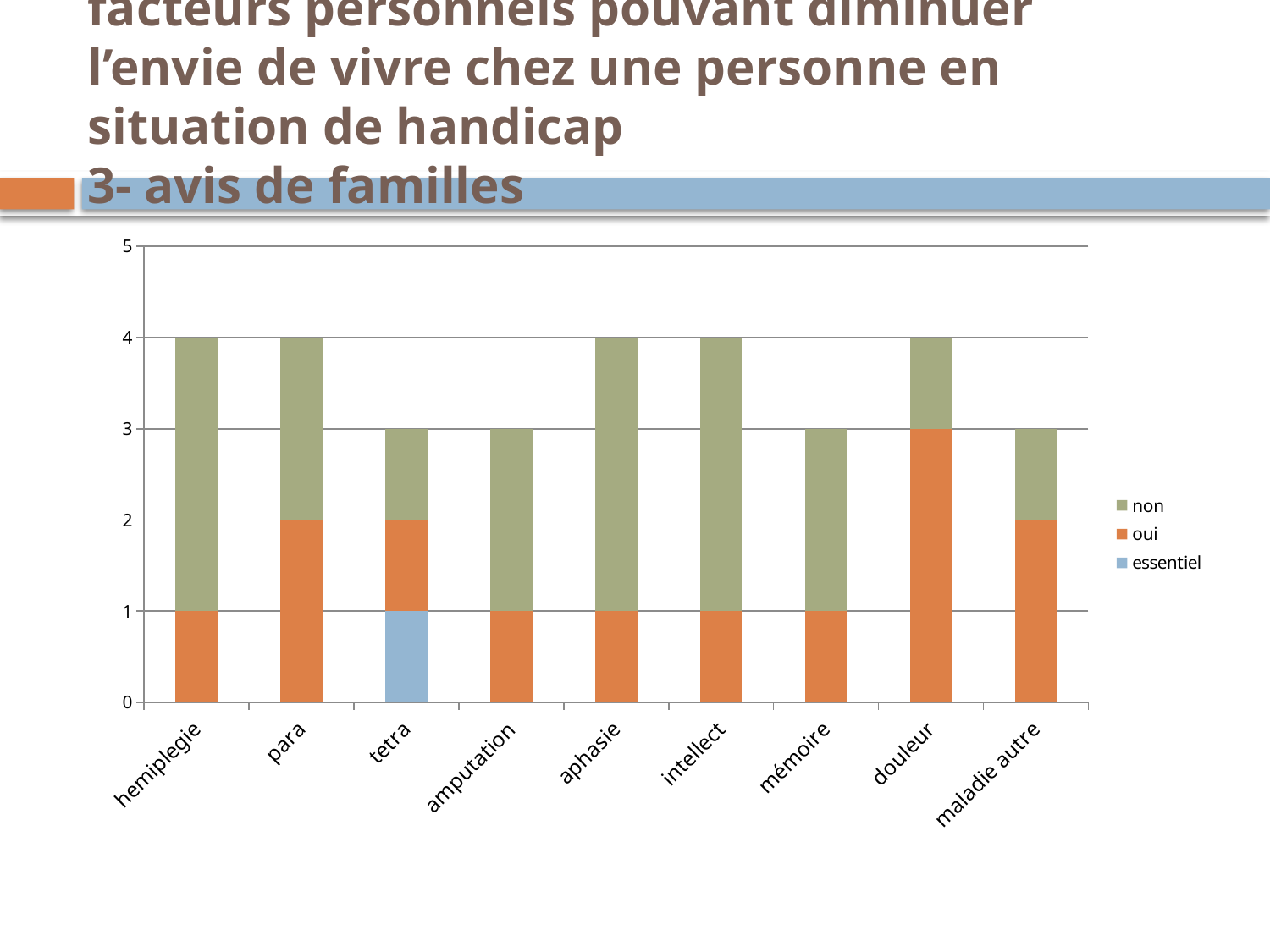
What is the total height of the stacked bar for hemiplegie? 4 Which legend entry is shown in orange? oui Which category is the only one with an 'essentiel' segment? tetra How many categories are shown along the x axis of the chart? 9 How many series does the chart legend list? 3 What is the total height of the stacked bar for tetra? 3 What is the value of the 'non' segment for hemiplegie? 3 What is the value of the 'oui' segment for douleur? 3 Which category has the largest 'oui' segment? douleur Is the total stacked bar for amputation taller or shorter than the total stacked bar for aphasie? shorter What is the total height of the stacked bar for douleur? 4 What kind of chart is shown on the slide? bar chart